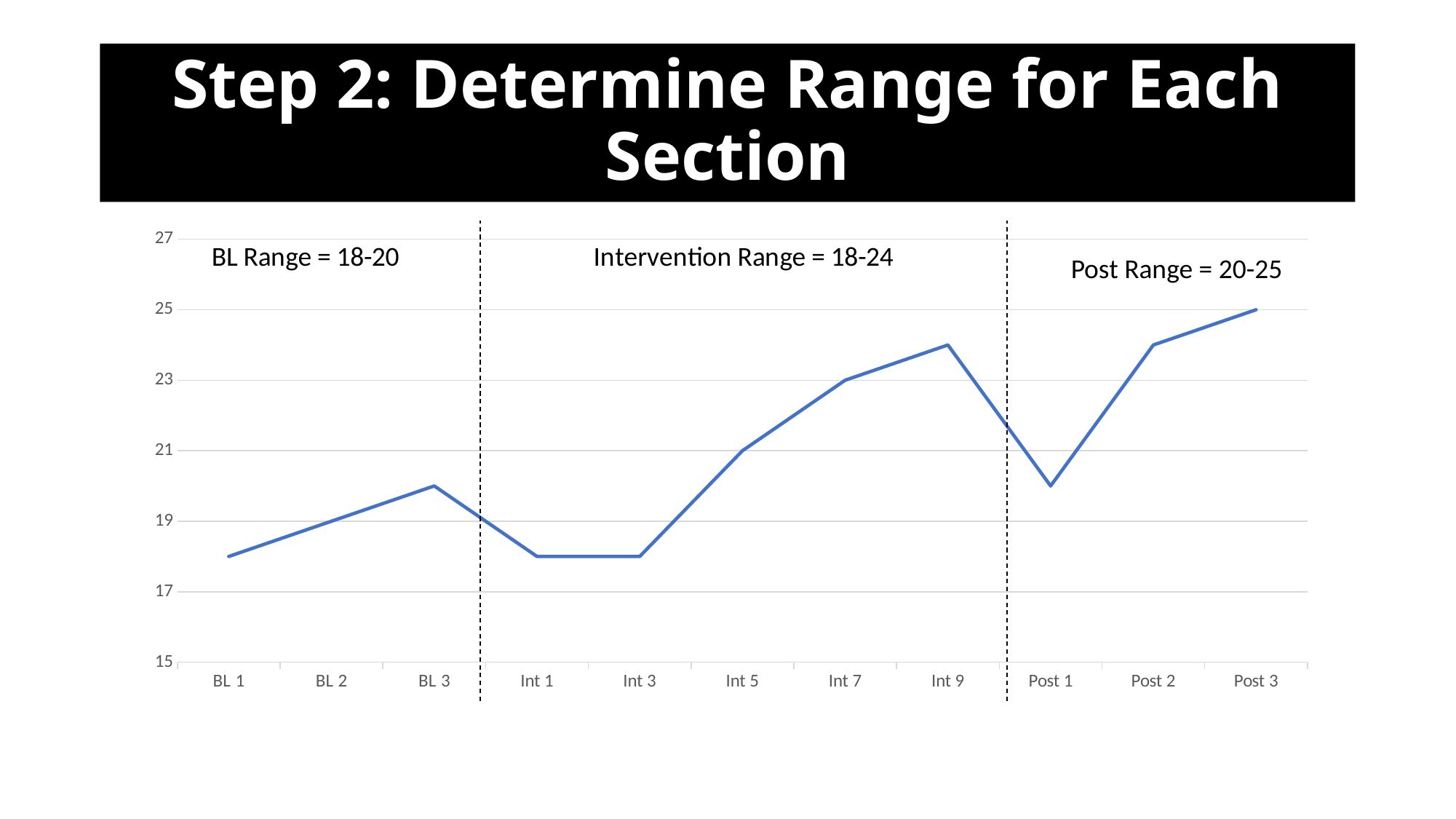
Is the value at Int 1 greater or less than 19? less What is the value at BL 2? 19 What is the value at Post 3? 25 What is the value at Int 5? 21 What is the value at Int 7? 23 Which is larger, the value at Post 2 or the value at Post 1? Post 2 Is the value at Int 9 greater or less than 23? greater How many data points are plotted along the x axis? 11 Do the values rise or fall from Int 3 to Int 9? rise What kind of chart is shown on the slide? line chart What range is given for the Intervention section in the annotation? 18-24 Which point has the highest value? Post 3